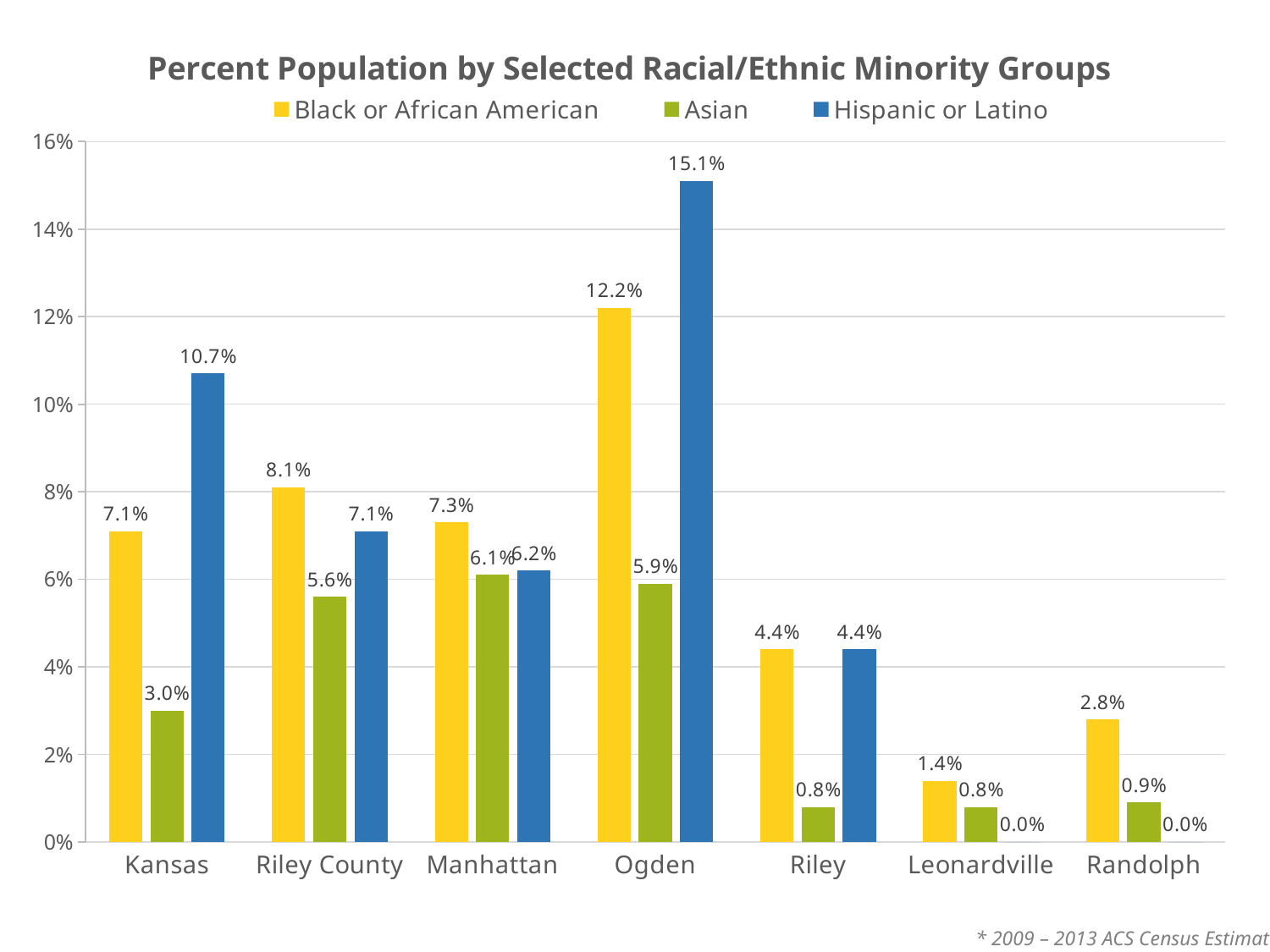
Which category has the lowest Black or African American percentage? Leonardville Which is larger for Manhattan: the Black or African American percentage or the Asian percentage? Black or African American Which category has the highest Hispanic or Latino percentage? Ogden What is the title of the chart? Percent Population by Selected Racial/Ethnic Minority Groups What is the Asian percentage for Kansas? 3.0% How many categories are shown on the x axis? 7 How many series does the legend list? 3 What kind of chart is shown on the slide? Bar chart What is the difference between the Hispanic or Latino percentage for Kansas and for Riley County? 3.6% What is the Hispanic or Latino percentage for Ogden? 15.1% Is the Black or African American value for Ogden greater or less than 10%? greater What is the Black or African American percentage for Riley County? 8.1%